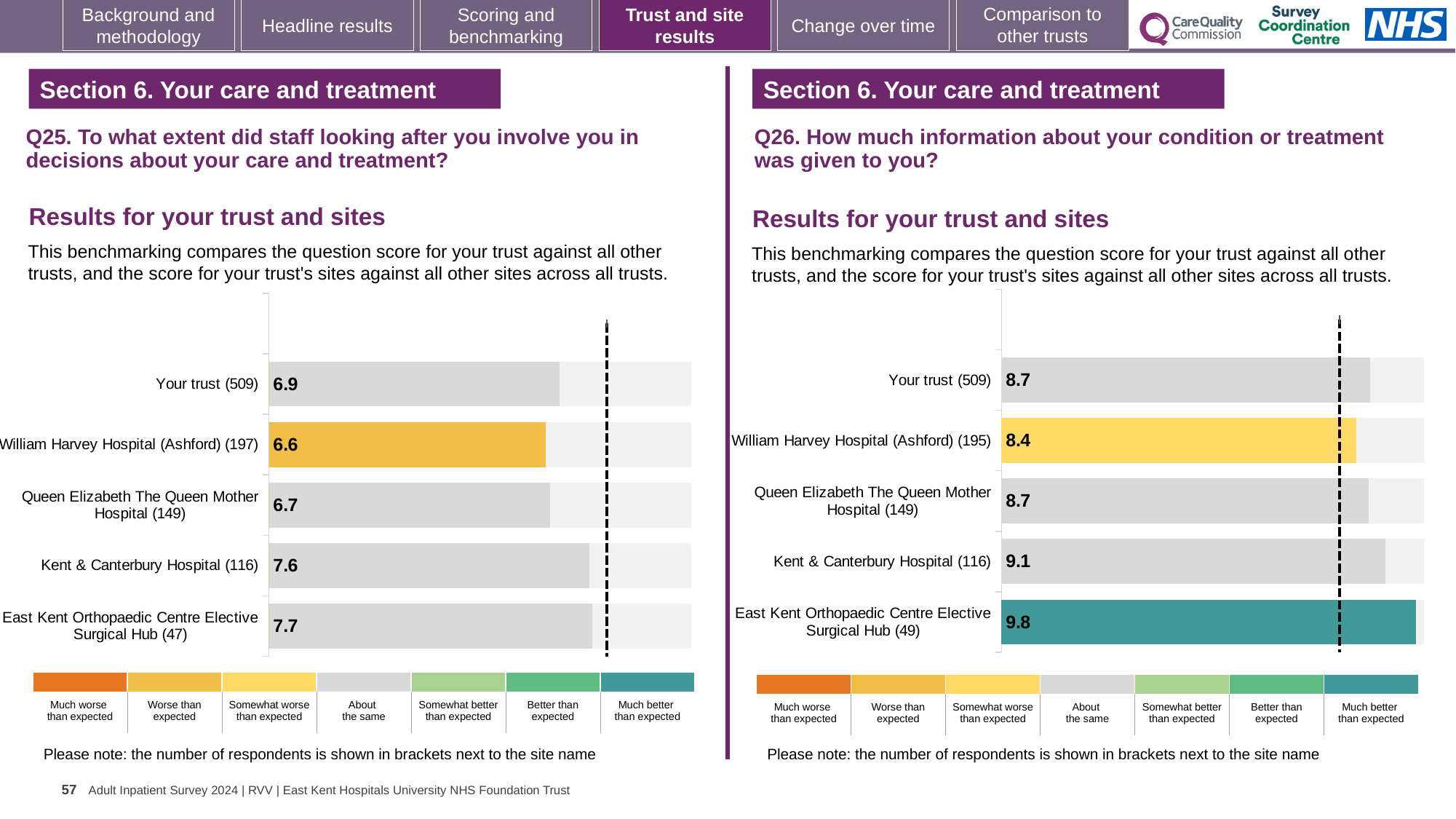
On the Q25 chart (left), what is the score for William Harvey Hospital (Ashford) (197)? 6.6 What kind of chart is used on the Q25 chart (left)? Bar chart On the Q25 chart (left), which site has the highest score? East Kent Orthopaedic Centre Elective Surgical Hub (47) On the Q26 chart (right), what is the score for Kent & Canterbury Hospital (116)? 9.1 On the Q26 chart (right), what is the score for East Kent Orthopaedic Centre Elective Surgical Hub (49)? 9.8 On the Q25 chart (left), how many bars are plotted? 5 On the Q25 chart (left), what is the score for Your trust (509)? 6.9 On the Q25 chart (left), what is the difference between the scores for Kent & Canterbury Hospital (116) and Queen Elizabeth The Queen Mother Hospital (149)? 0.9 On the Q25 chart (left), which site has the lowest score? William Harvey Hospital (Ashford) (197) On the Q26 chart (right), which site has the lowest score? William Harvey Hospital (Ashford) (195) On the Q26 chart (right), what is the difference between the scores for East Kent Orthopaedic Centre Elective Surgical Hub (49) and Your trust (509)? 1.1 On the Q26 chart (right), which is larger: the score for Your trust (509) or the score for William Harvey Hospital (Ashford) (195)? Your trust (509)